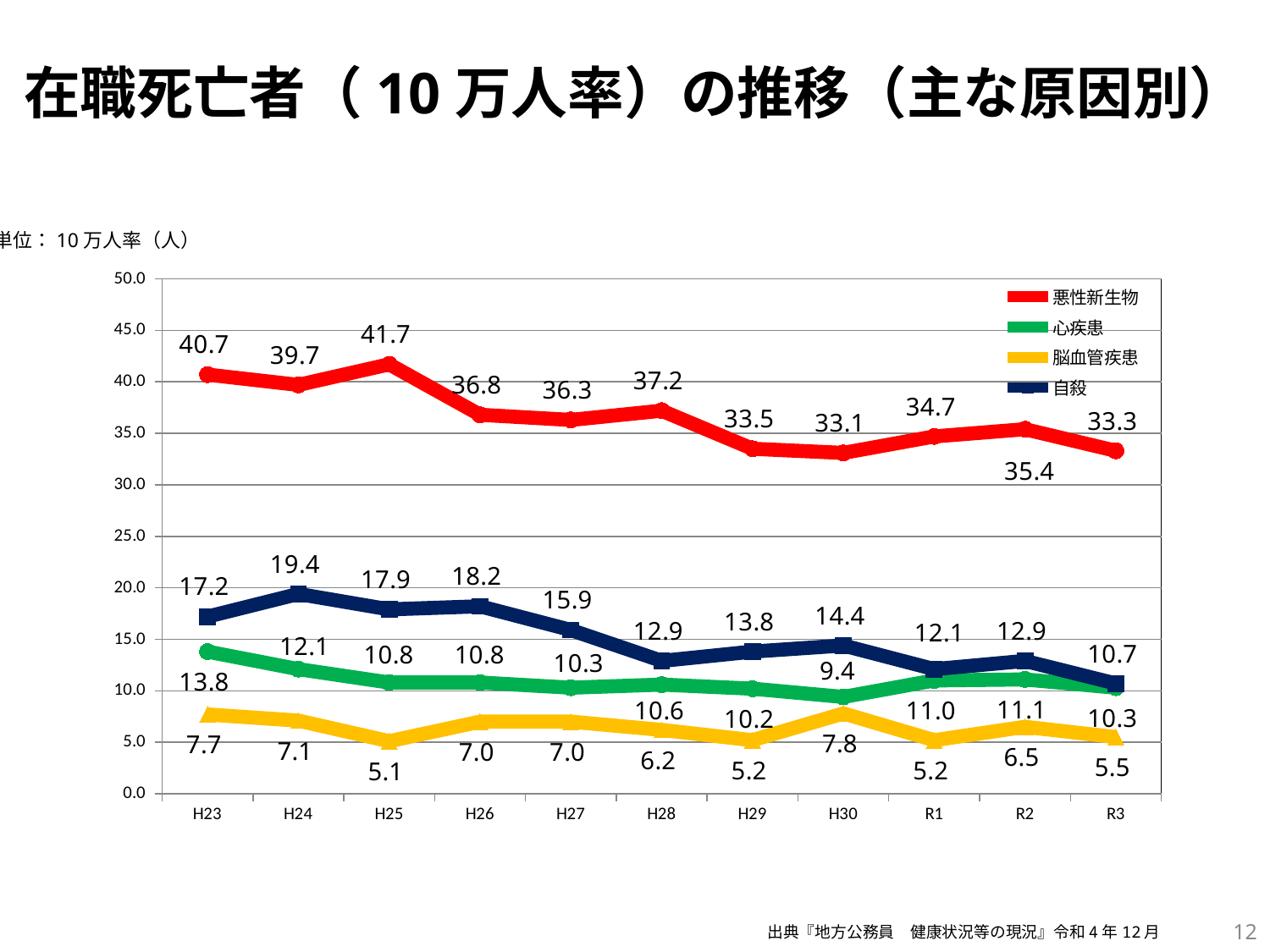
How many years (points) are plotted along the x axis? 11 What is the value for 悪性新生物 in H25? 41.7 What is the difference between the 悪性新生物 values in H23 and R3? 7.4 Which is larger in H24: the value for 自殺 or the value for 心疾患? 自殺 In which year is the 悪性新生物 value highest? H25 What is the value for 脳血管疾患 in H30? 7.8 What kind of chart is shown on the slide? line chart How many series does the legend list? 4 In which year is the 自殺 value lowest? R3 What is the value for 自殺 in R3? 10.7 Overall, does the 悪性新生物 line rise or fall from H23 to R3? fall Which colour is used for the 脳血管疾患 series? yellow